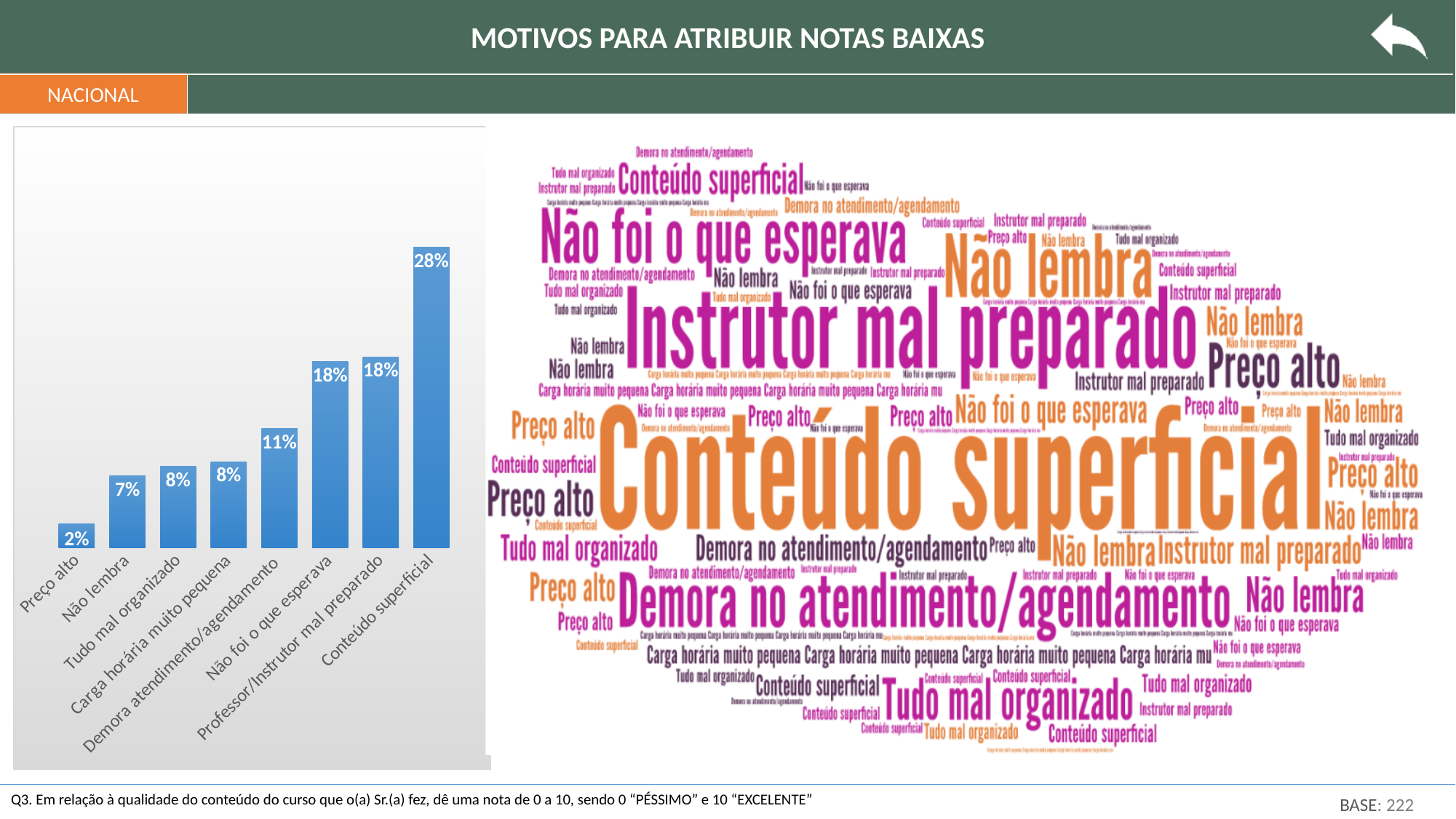
Do the values in the bar chart rise or fall from left to right along the x axis? Rise What is the title of the slide containing the bar chart? MOTIVOS PARA ATRIBUIR NOTAS BAIXAS What percentage is shown for "Conteúdo superficial" in the bar chart? 28% What type of chart is used on the left side of the slide? Bar chart Which category has the lowest value in the bar chart? Preço alto What is the difference between the values for "Conteúdo superficial" and "Não foi o que esperava" in the bar chart? 10% What value does the bar chart show for "Não lembra"? 7% Which category has the highest value in the bar chart? Conteúdo superficial Which is larger in the bar chart: the value for "Demora atendimento/agendamento" or the value for "Tudo mal organizado"? Demora atendimento/agendamento What percentage is shown for "Preço alto" in the bar chart? 2% How many categories are shown in the bar chart? 8 What value does the bar chart show for "Demora atendimento/agendamento"? 11%